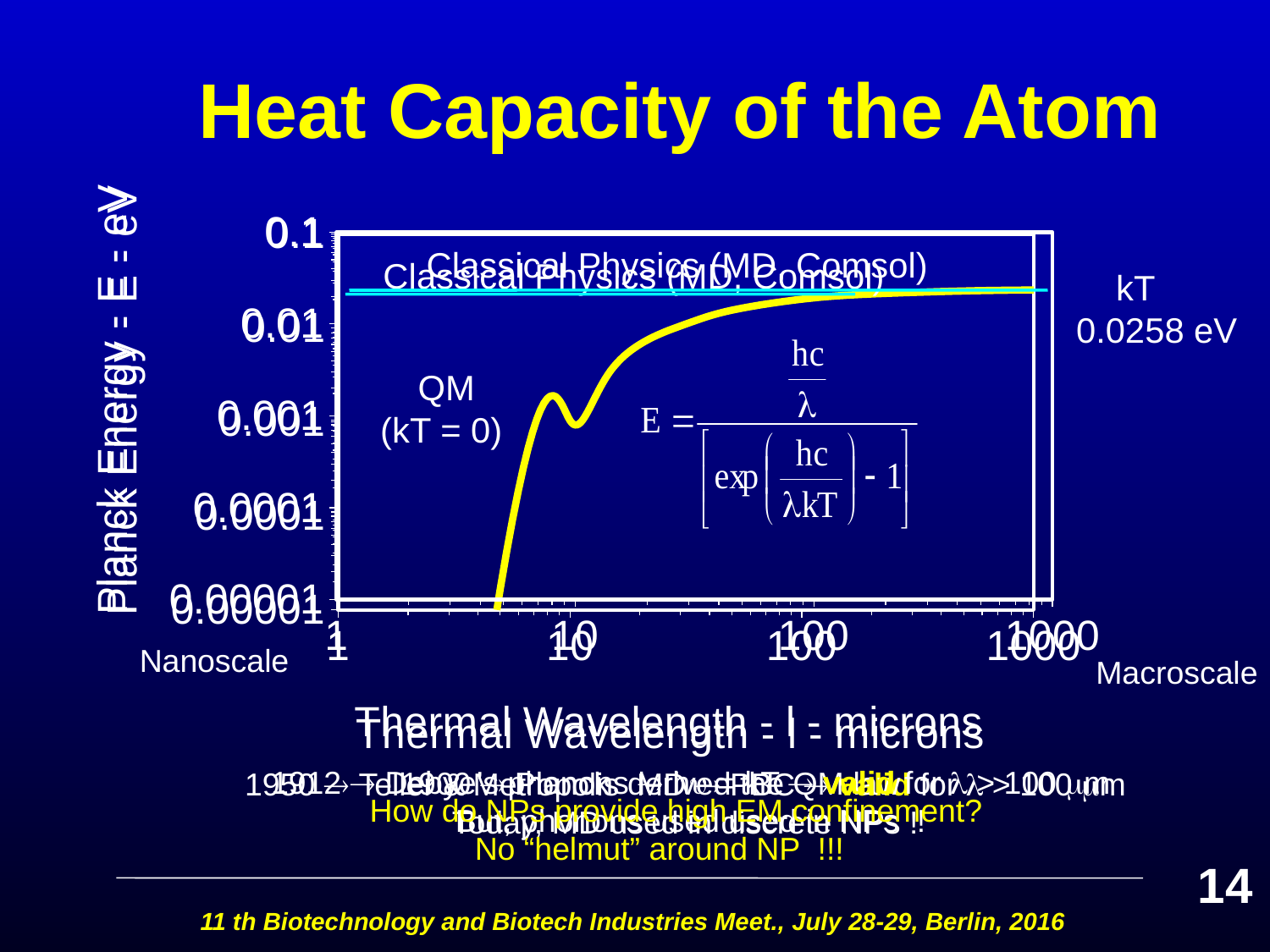
What is the highest value shown on the x axis? 1000 How many labelled tick values are shown on the x axis? 4 Is the value of the QM curve at a thermal wavelength of 1000 microns greater or less than 0.1? less What is the title of the slide containing the chart? Heat Capacity of the Atom How many curves are plotted on the chart? 2 What kind of chart is shown on the slide? line chart What is the lowest value shown on the y axis? 0.00001 What label is given to the horizontal cyan line on the chart? Classical Physics (MD, Comsol) At a thermal wavelength of 10 microns, which is higher: the classical physics line or the QM curve? the classical physics line What value of kT is printed next to the horizontal classical physics line? 0.0258 eV Is the value of the QM curve at a thermal wavelength of 100 microns greater or less than 0.01? greater Does the yellow QM curve rise or fall as thermal wavelength increases from 1 to 1000 microns? rise